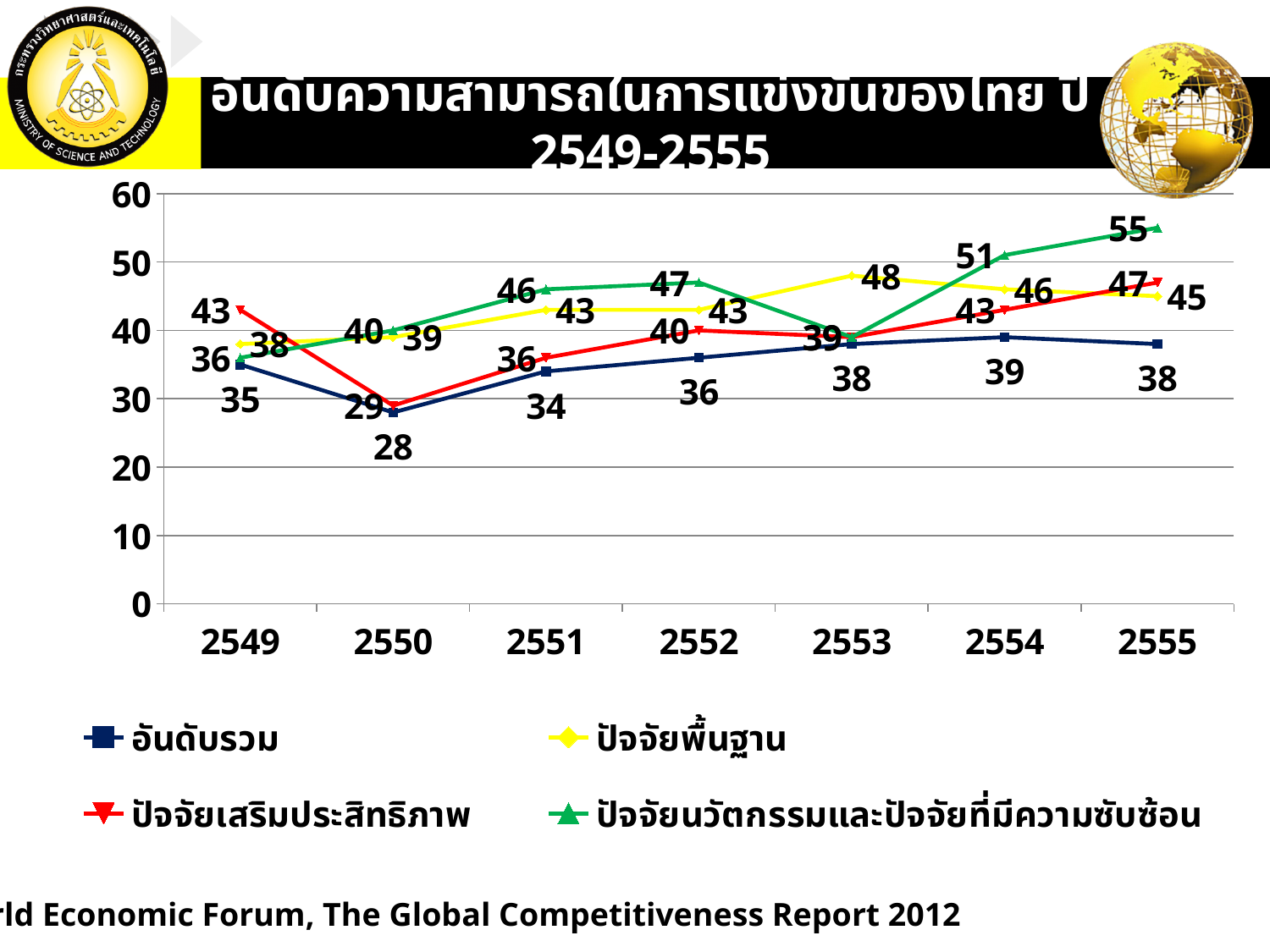
What is the difference between ปัจจัยนวัตกรรมและปัจจัยที่มีความซับซ้อน and อันดับรวม in 2555? 17 What is the value of ปัจจัยเสริมประสิทธิภาพ in 2549? 43 How many series does the legend list? 4 Which is larger in 2554: ปัจจัยพื้นฐาน or ปัจจัยเสริมประสิทธิภาพ? ปัจจัยพื้นฐาน What is the value of ปัจจัยพื้นฐาน in 2553? 48 What is the value of ปัจจัยนวัตกรรมและปัจจัยที่มีความซับซ้อน in 2555? 55 In which year is the value of ปัจจัยนวัตกรรมและปัจจัยที่มีความซับซ้อน highest? 2555 Does the value of ปัจจัยนวัตกรรมและปัจจัยที่มีความซับซ้อน rise or fall from 2553 to 2555? Rise In which year is the value of อันดับรวม lowest? 2550 How many years are plotted along the x axis? 7 What kind of chart is shown on the slide? Line chart What is the value of อันดับรวม in 2550? 28